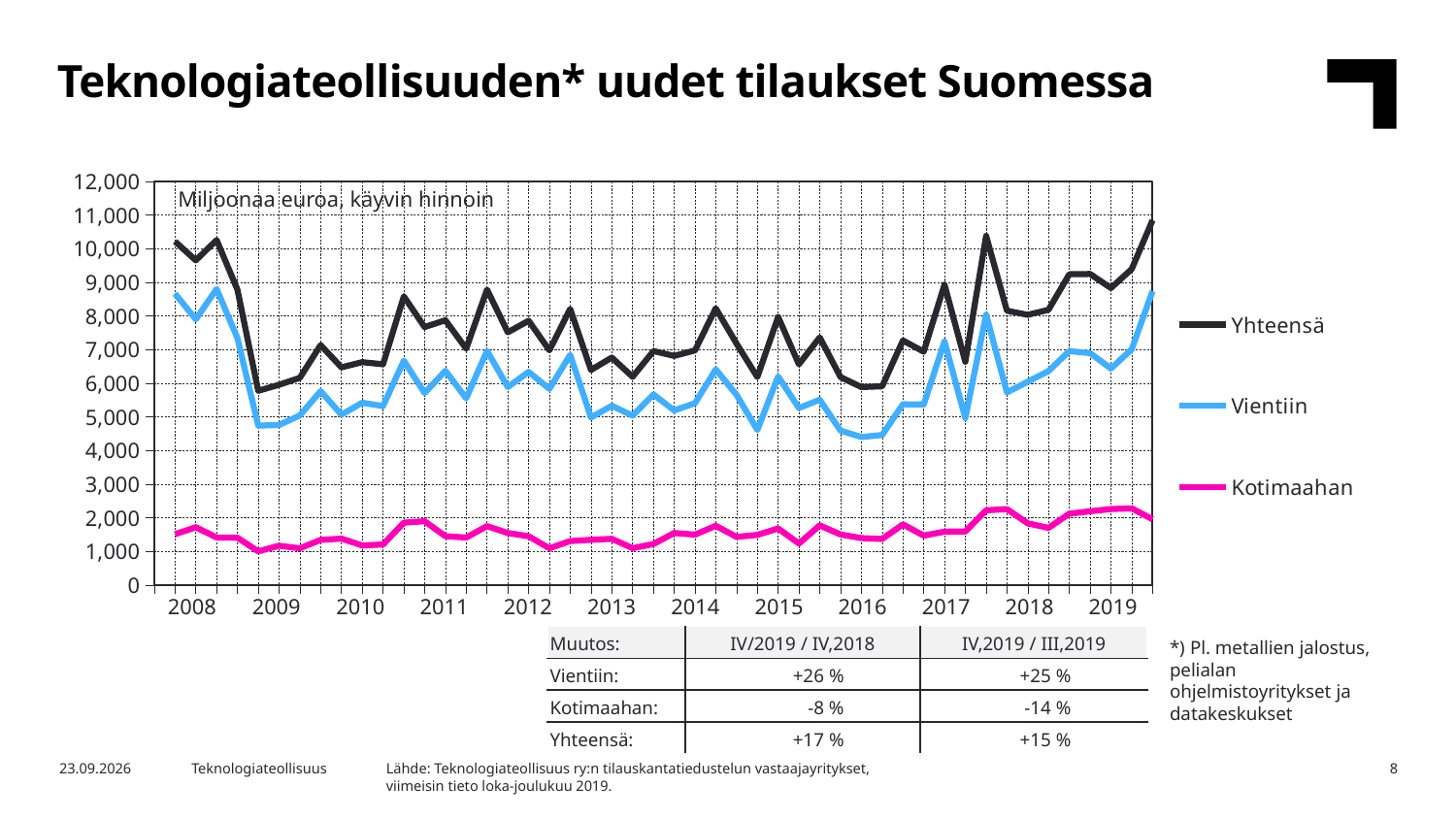
Is the value for Yhteensä at the start of 2008 greater or less than 9,000? greater What kind of chart is shown on the slide? line chart Does the Yhteensä line rise or fall from the start of 2008 to the start of 2009? fall Is the value for Kotimaahan in 2019 greater or less than 3,000? less Which is larger at the end of 2019, Yhteensä or Vientiin? Yhteensä Is the lowest value for Vientiin in 2016 greater or less than 5,000? less Which series has the highest values across the whole period? Yhteensä What are the three series named in the legend? Yhteensä, Vientiin, Kotimaahan Which series has the lowest values across the whole period? Kotimaahan What unit label is printed inside the chart area? Miljoonaa euroa, käyvin hinnoin How many series does the chart's legend list? 3